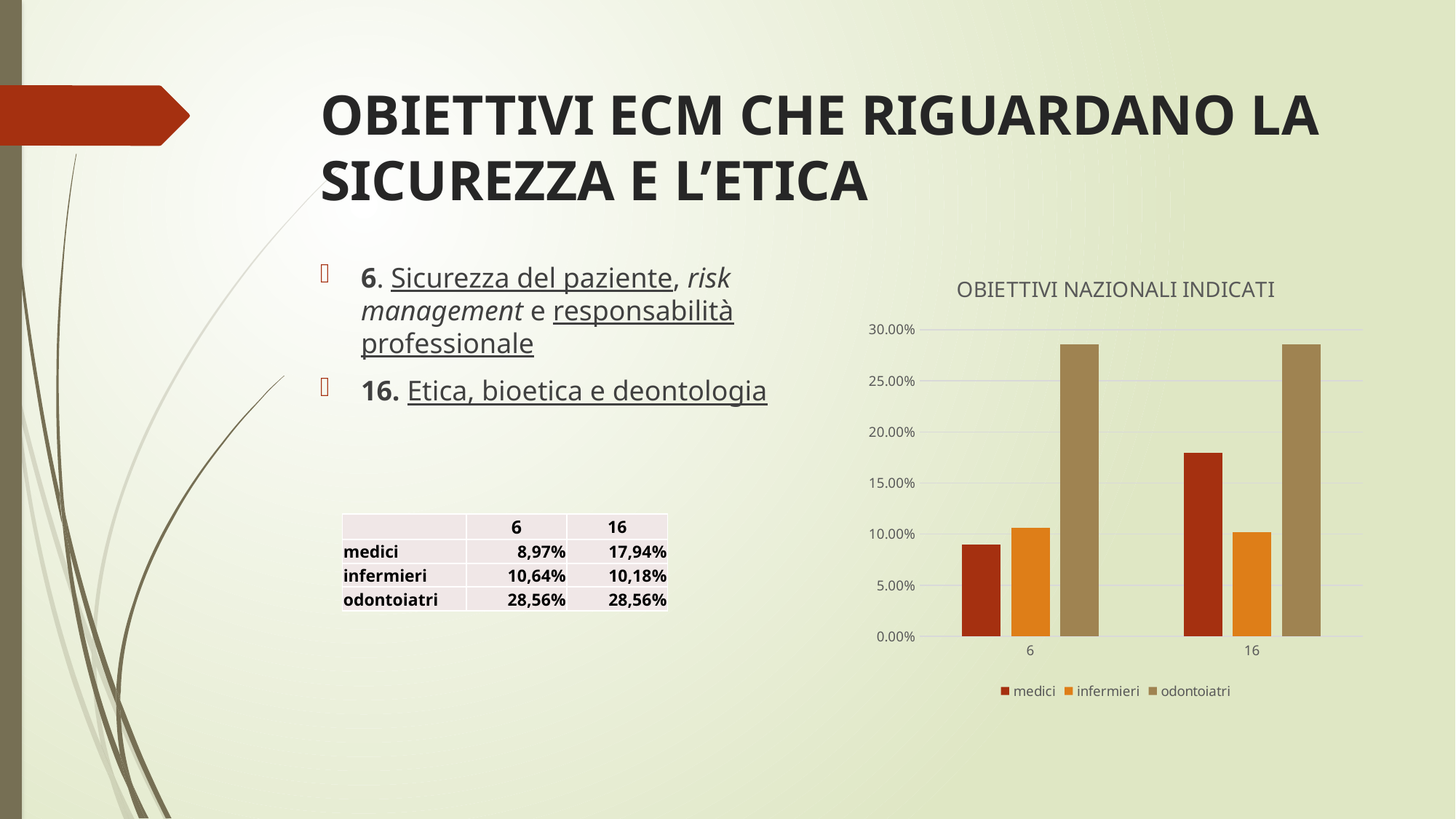
What is the title of the chart? OBIETTIVI NAZIONALI INDICATI How many categories are shown on the x axis of the chart? 2 Does the medici series rise or fall from category 6 to category 16? rise How many series does the legend of the chart list? 3 According to the slide, what is the value for medici in category 16? 17,94% What kind of chart is shown on the slide? bar chart Is the value for odontoiatri in category 6 greater or less than 25.00%? greater Which series has the highest value for category 6? odontoiatri For the medici series, which category has the larger value, 6 or 16? 16 According to the slide, what is the value for infermieri in category 6? 10,64% Which series has the lowest value for category 6? medici Is the value for medici in category 6 greater or less than 10.00%? less